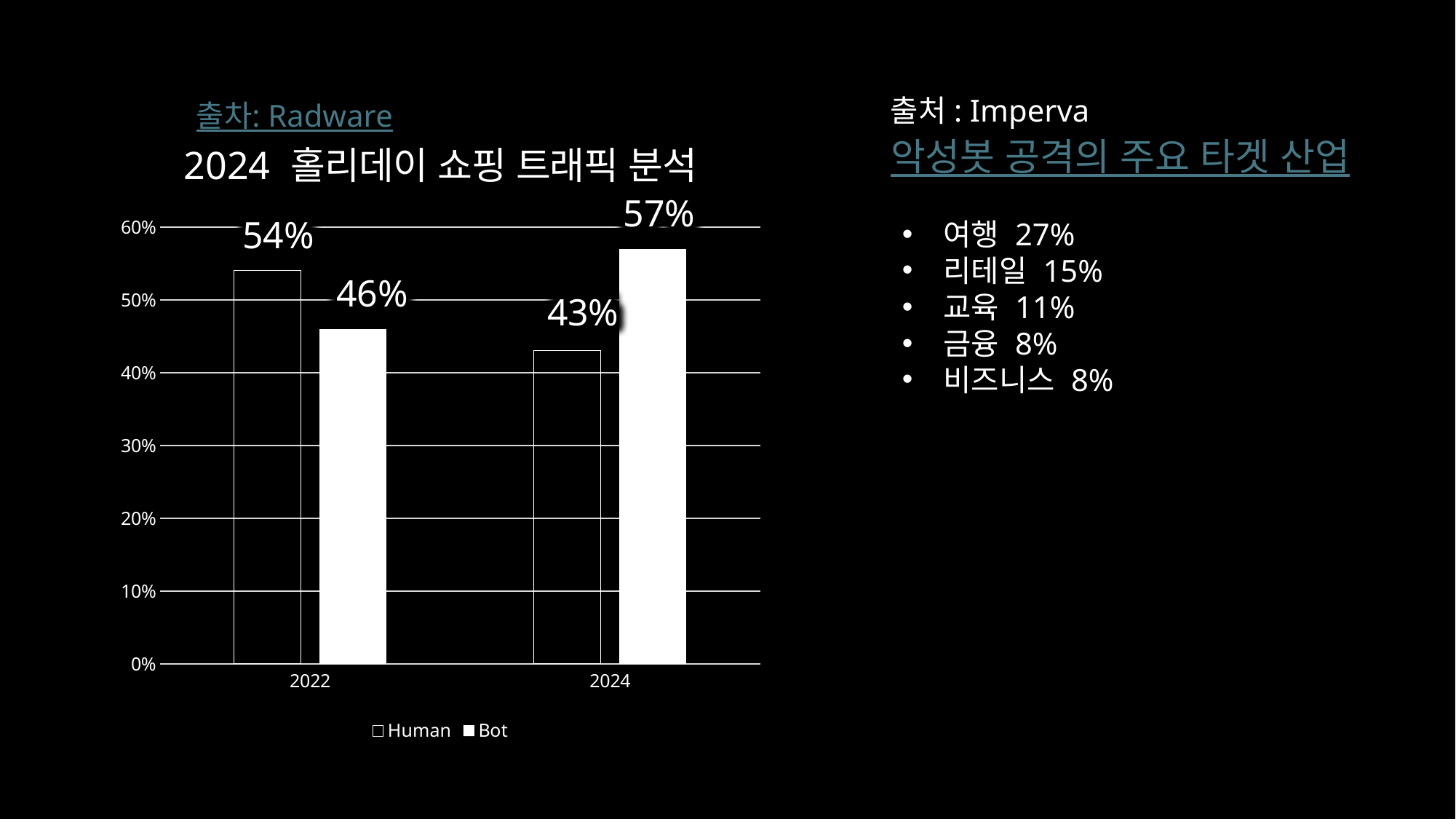
What is the Bot value for 2022? 46% What is the difference between the Bot values for 2024 and 2022? 11% What is the difference between the Human and Bot values in 2022? 8% What is the Human value for 2024? 43% How many series does the legend list? 2 What is the title of the chart? 2024 홀리데이 쇼핑 트래픽 분석 How many categories are shown on the x axis? 2 What is the Human value for 2022? 54% What kind of chart is shown on the slide? bar chart Which series has the higher value in 2024, Human or Bot? Bot Does the Human value rise or fall from 2022 to 2024? fall What is the Bot value for 2024? 57%